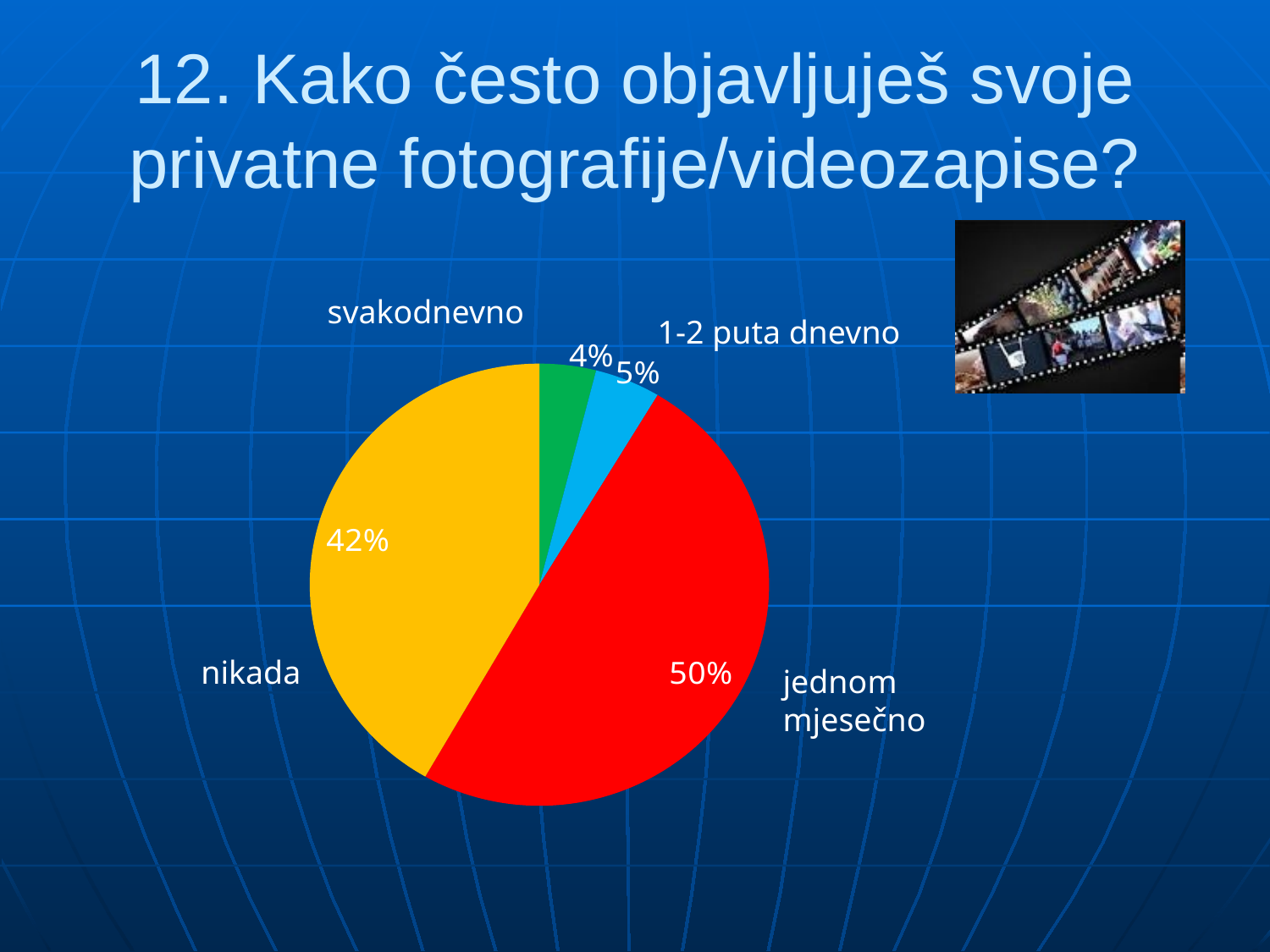
What is the difference in percentage points between "jednom mjesečno" and "nikada"? 8 What percentage of the pie is labelled "jednom mjesečno"? 50% Which category has the largest slice of the pie? jednom mjesečno What percentage of the pie is labelled "svakodnevno"? 4% Which is larger, the slice for "1-2 puta dnevno" or the slice for "svakodnevno"? 1-2 puta dnevno What colour is the slice for "nikada"? yellow What kind of chart is shown on the slide? pie chart What percentage of the pie is labelled "1-2 puta dnevno"? 5% What colour is the slice for "jednom mjesečno"? red Which category has the smallest slice of the pie? svakodnevno What percentage of the pie is labelled "nikada"? 42% How many slices does the pie chart have? 4